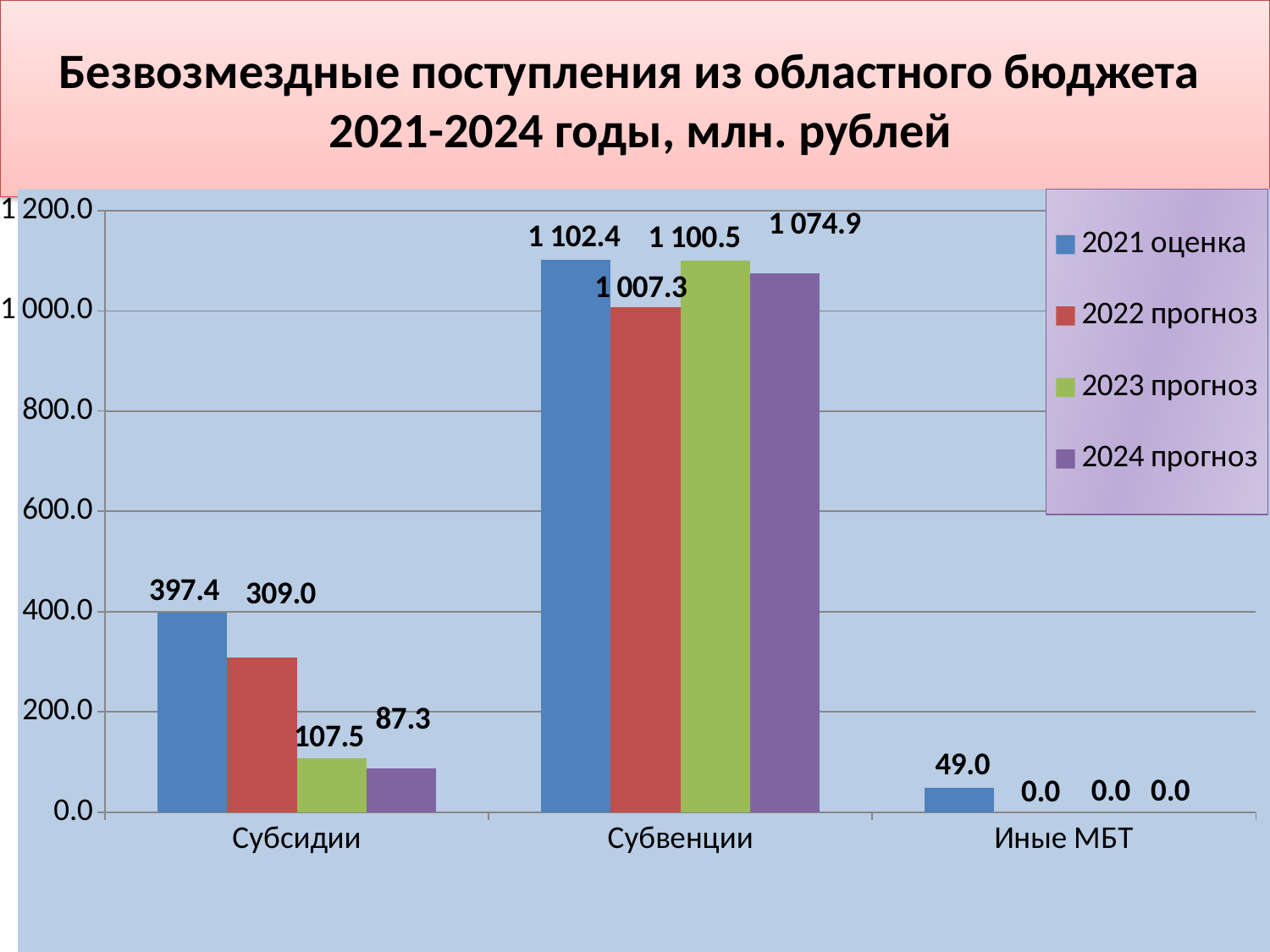
How many series does the legend list? 4 How many categories are shown on the x axis? 3 Which category has the lowest value in the 2022 прогноз series? Иные МБТ What kind of chart is shown on the slide? Bar chart What is the difference between the 2021 оценка and 2022 прогноз values for Субсидии? 88.4 What is the value for Субсидии in the 2021 оценка series? 397.4 What is the value for Иные МБТ in the 2021 оценка series? 49.0 Which category has the highest value in the 2023 прогноз series? Субвенции Do the values for Субсидии rise or fall from 2021 оценка to 2024 прогноз? Fall What is the value for Субвенции in the 2022 прогноз series? 1 007.3 What is the value for Субсидии in the 2024 прогноз series? 87.3 Which is larger for Субвенции: the 2021 оценка value or the 2024 прогноз value? 2021 оценка